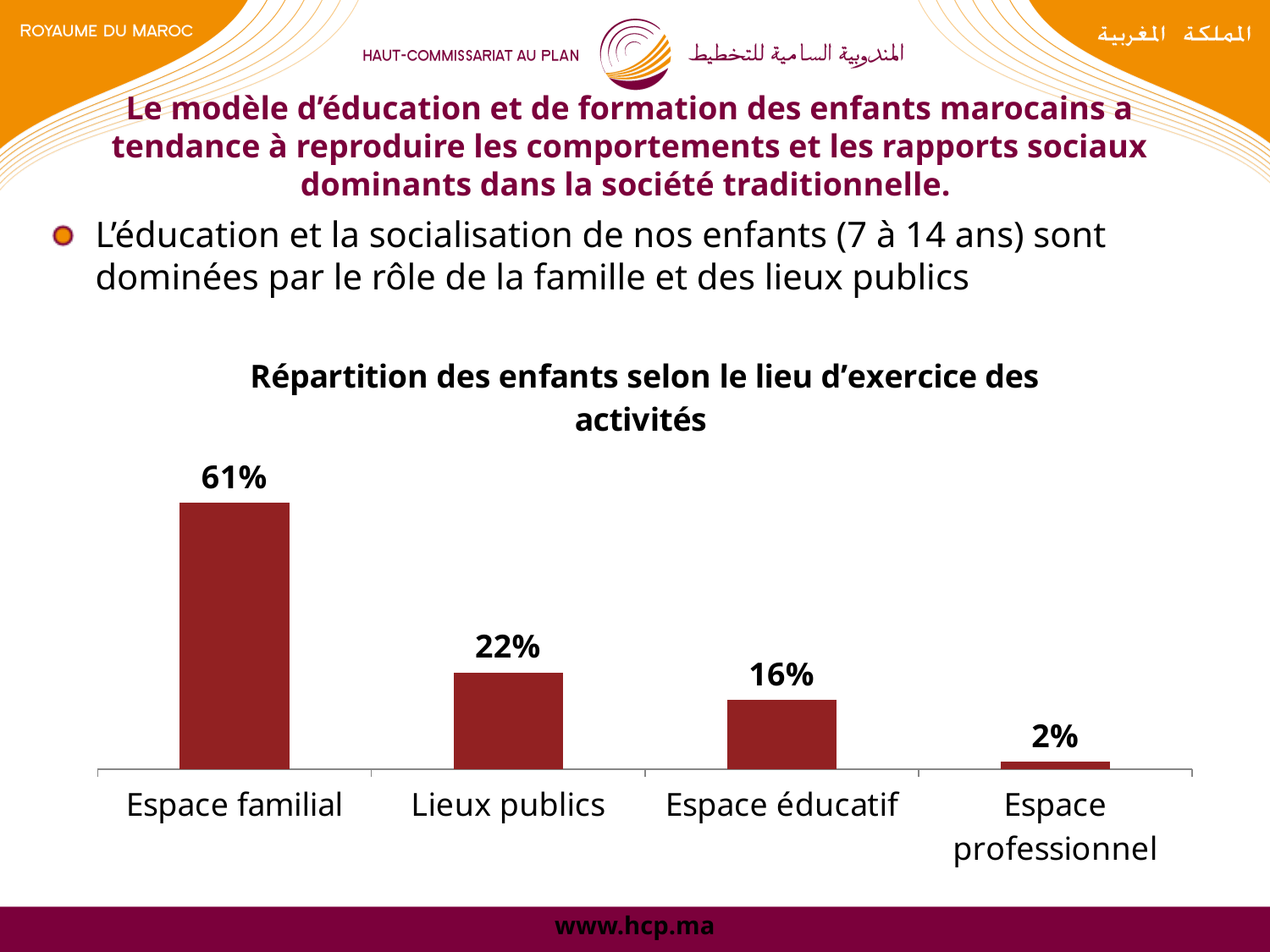
What is the difference between the values for Lieux publics and Espace éducatif? 6% What kind of chart is shown on the slide? Bar chart What is the title of the chart? Répartition des enfants selon le lieu d'exercice des activités Which category has the lowest value? Espace professionnel What is the value for Lieux publics? 22% What is the value for Espace professionnel? 2% What is the value for Espace familial? 61% What is the difference between the values for Espace familial and Lieux publics? 39% Which is larger, the value for Espace éducatif or the value for Espace professionnel? Espace éducatif What is the value for Espace éducatif? 16% Which category has the highest value? Espace familial How many categories are shown in the chart? 4